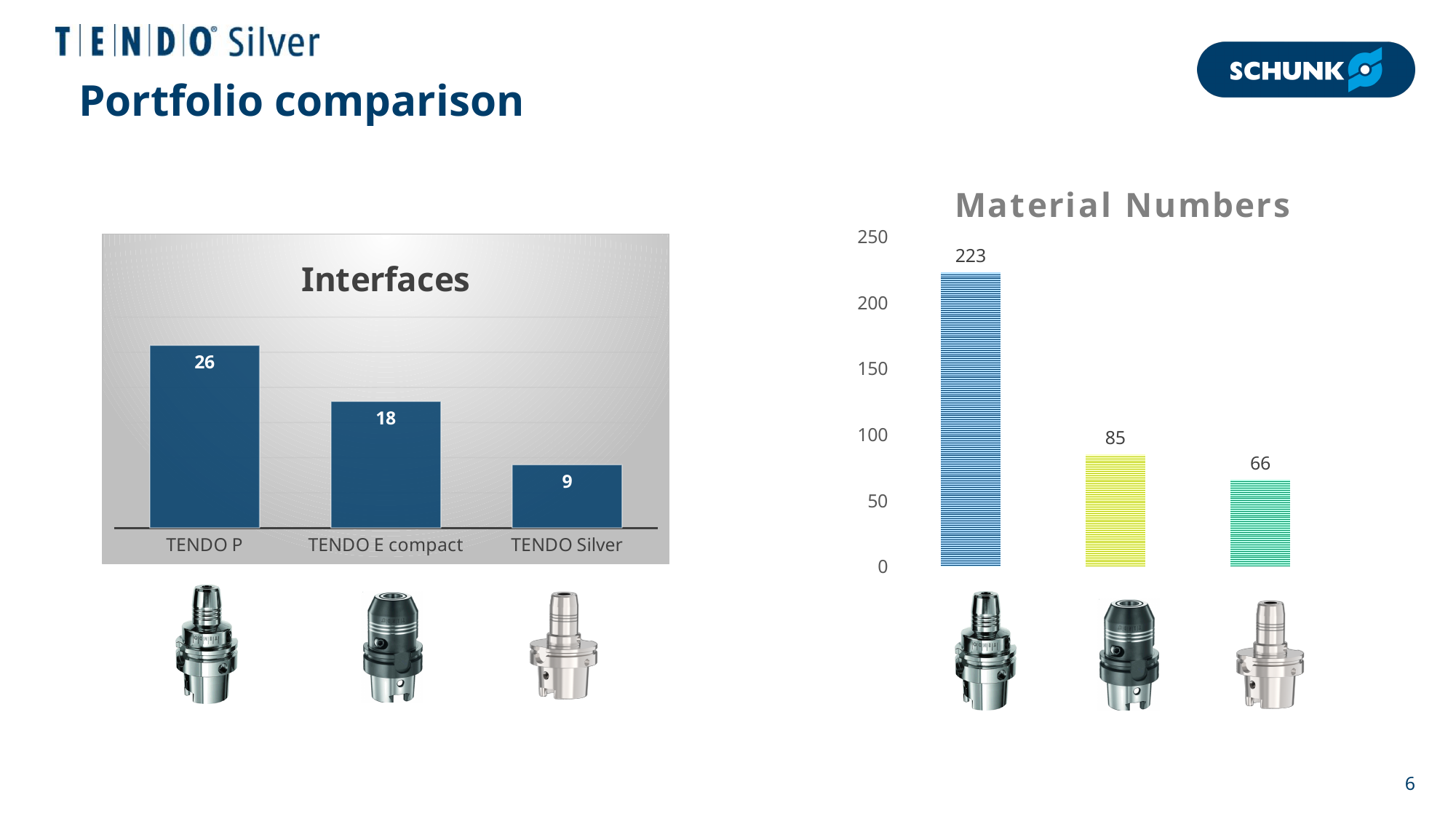
What kind of chart is the Material Numbers chart? bar chart In the Interfaces chart, what is the value for TENDO P? 26 In the Material Numbers chart, what is the value of the rightmost (green) bar? 66 In the Interfaces chart, what is the value for TENDO E compact? 18 In the Interfaces chart, do the values rise or fall from left to right? fall In the Material Numbers chart, what is the difference between the leftmost bar and the middle bar? 138 In the Interfaces chart, which category has the lowest value? TENDO Silver In the Interfaces chart, what is the difference between the values for TENDO P and TENDO Silver? 17 In the Interfaces chart, how many categories are shown? 3 In the Interfaces chart, what is the value for TENDO Silver? 9 In the Interfaces chart, which category has the highest value? TENDO P In the Material Numbers chart, what is the value of the leftmost (blue) bar? 223